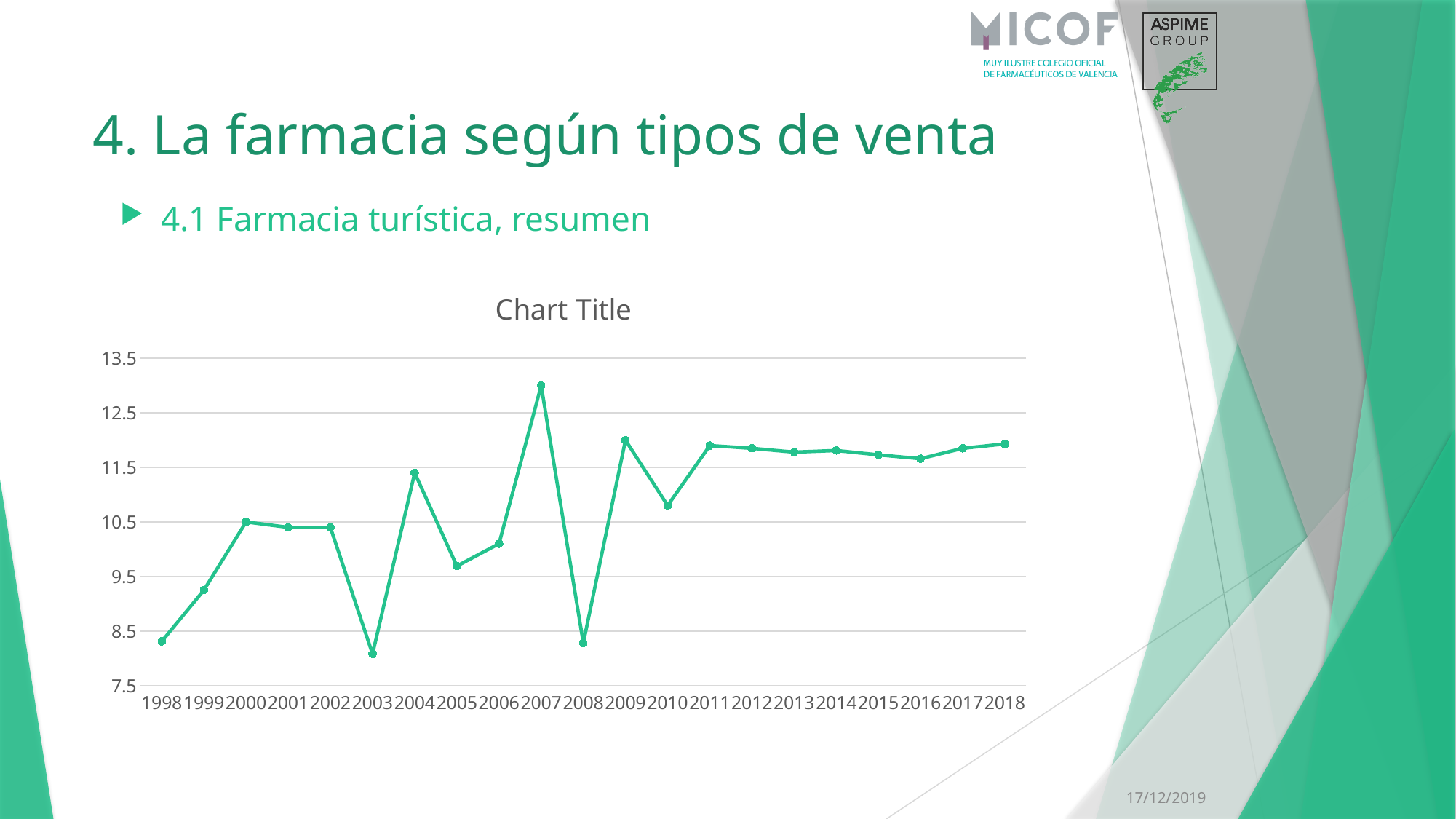
What is the title shown above the chart? Chart Title Which year has the highest value on the chart? 2007 How many years (data points) are plotted along the x axis? 21 Is the value for 2007 greater or less than 12.5? greater Does the value rise or fall from 1998 to 2000? rise Is the value for 2010 greater or less than 10.5? greater Which is larger, the value for 2007 or the value for 2008? 2007 Is the value for 2003 greater or less than 8.5? less Which is larger, the value for 2004 or the value for 2005? 2004 What kind of chart is shown on the slide? line chart